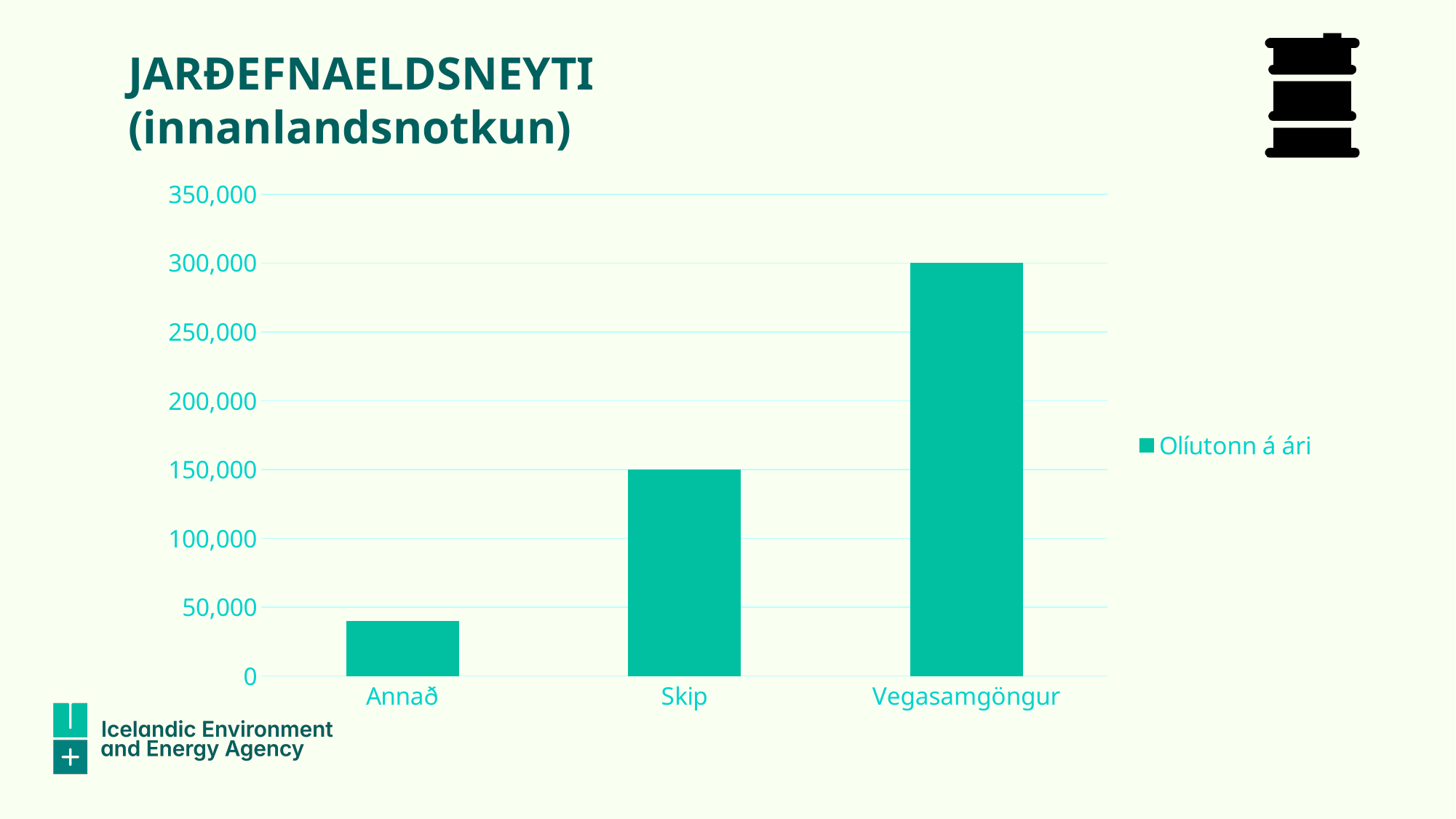
Is the value for Skip greater or less than 100,000? greater Which category has the highest value? Vegasamgöngur What is the value for Skip? 150,000 What is the difference between the values for Vegasamgöngur and Skip? 150,000 Is the value for Annað greater or less than 50,000? less How many series does the legend list? 1 What kind of chart is shown on the slide? bar chart How many categories are shown on the x axis? 3 What is the value for Vegasamgöngur? 300,000 What is the legend entry for the series? Olíutonn á ári Which category has the lowest value? Annað Which is larger, the value for Skip or the value for Annað? Skip